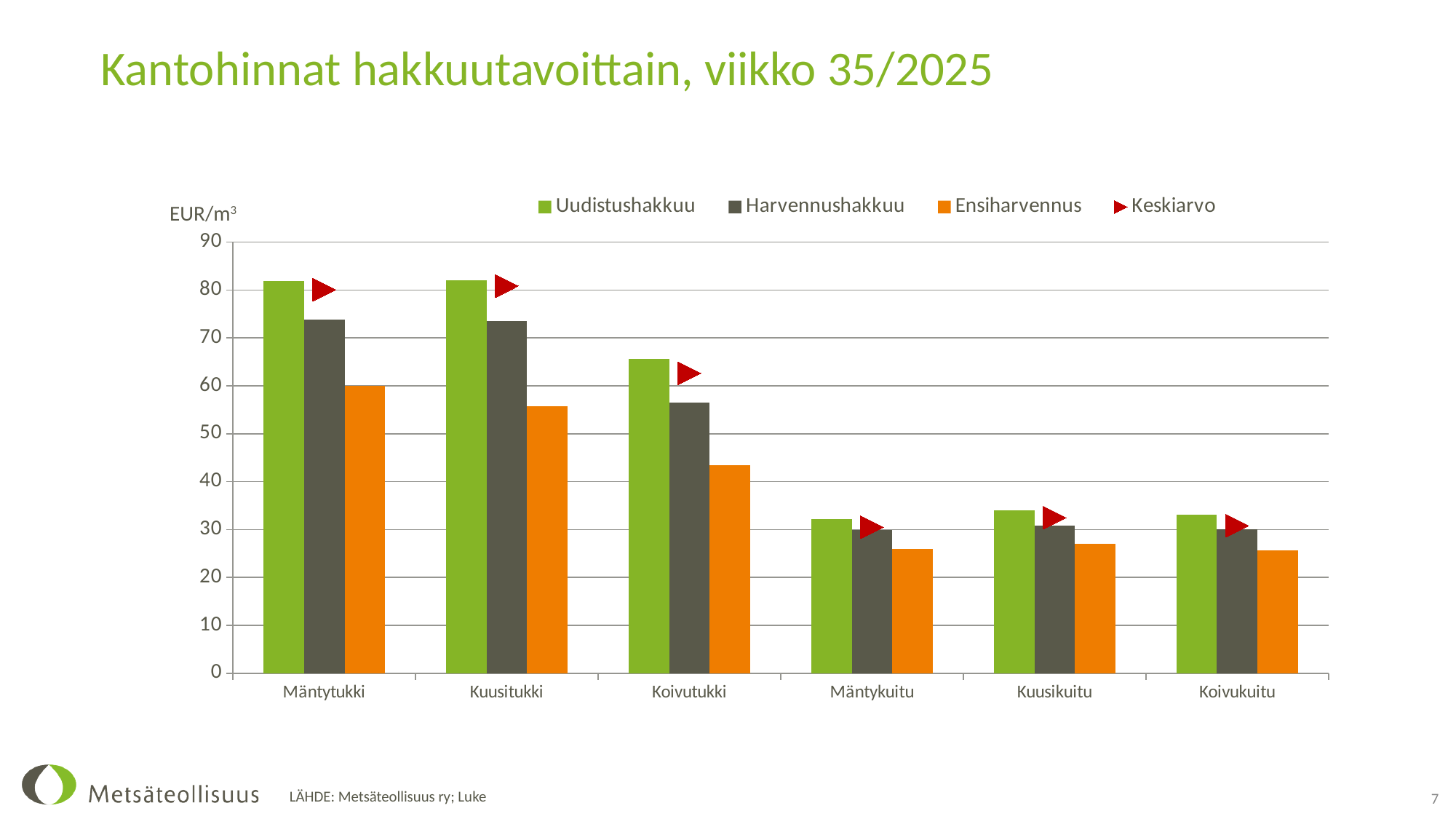
Which category has the highest Ensiharvennus value? Mäntytukki What kind of chart is shown on the slide? bar chart Which is larger, the Uudistushakkuu value for Mäntytukki or for Koivutukki? Mäntytukki Is the Ensiharvennus value for Koivutukki greater or less than 40? greater How many series does the legend list? 4 Which is larger, the Ensiharvennus value for Koivutukki or for Kuusikuitu? Koivutukki Is the Uudistushakkuu value for Mäntytukki greater or less than 80? greater What unit is shown on the y axis? EUR/m³ Is the Ensiharvennus value for Mäntykuitu greater or less than 30? less How many categories are shown on the x axis? 6